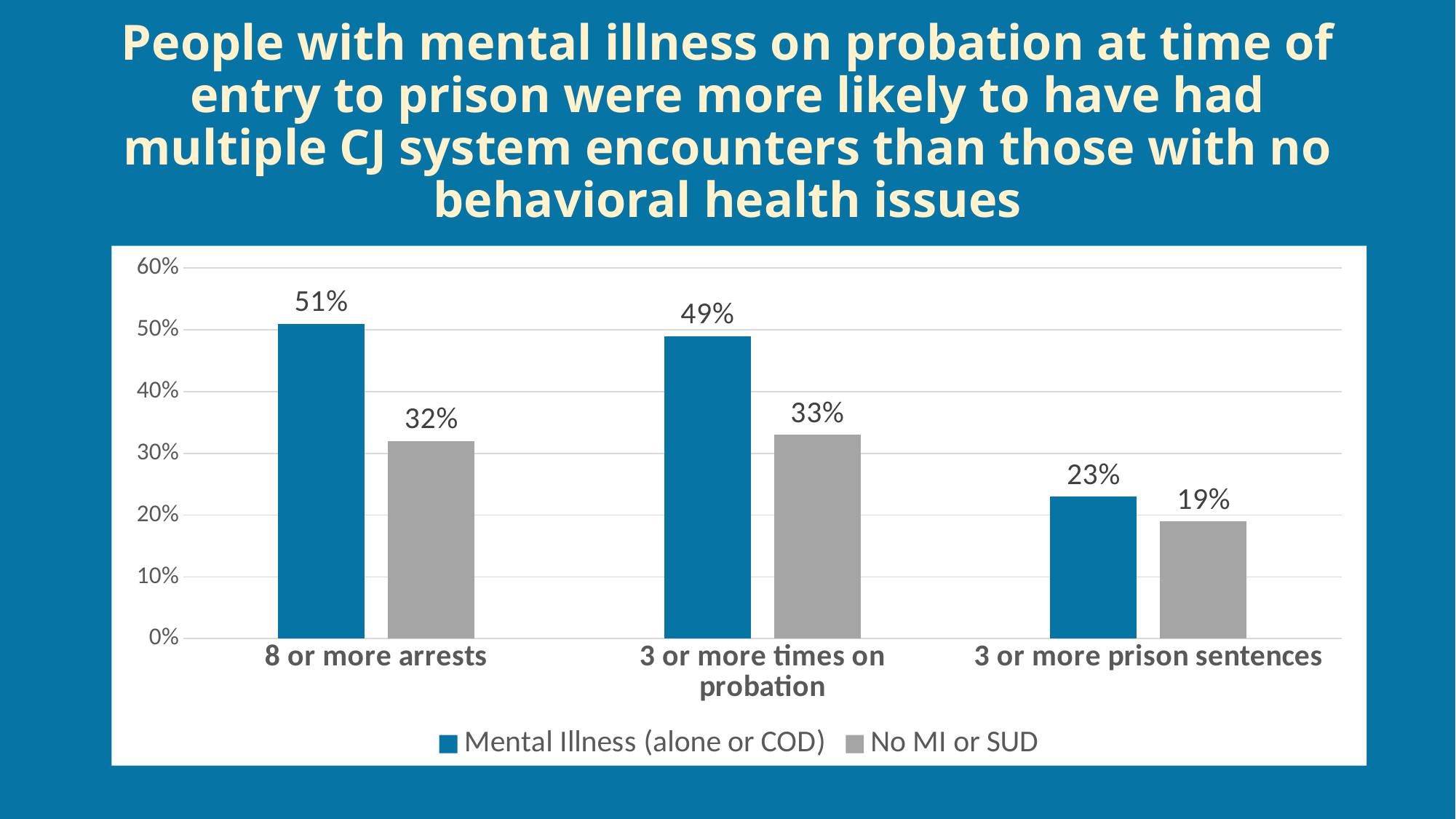
What is the value for Mental Illness (alone or COD) in the '3 or more prison sentences' category? 23% What kind of chart is shown on the slide? Bar chart How many categories are shown on the x axis? 3 What is the value for Mental Illness (alone or COD) in the '8 or more arrests' category? 51% Which colour represents the No MI or SUD series? Gray What is the difference between the Mental Illness (alone or COD) and No MI or SUD values in the '3 or more prison sentences' category? 4% Which category has the lowest value for the No MI or SUD series? 3 or more prison sentences In the '3 or more times on probation' category, which series has the larger value? Mental Illness (alone or COD) How many series does the legend list? 2 What is the value for No MI or SUD in the '3 or more times on probation' category? 33% What is the difference between the Mental Illness (alone or COD) and No MI or SUD values in the '8 or more arrests' category? 19% Which category has the highest value for the Mental Illness (alone or COD) series? 8 or more arrests